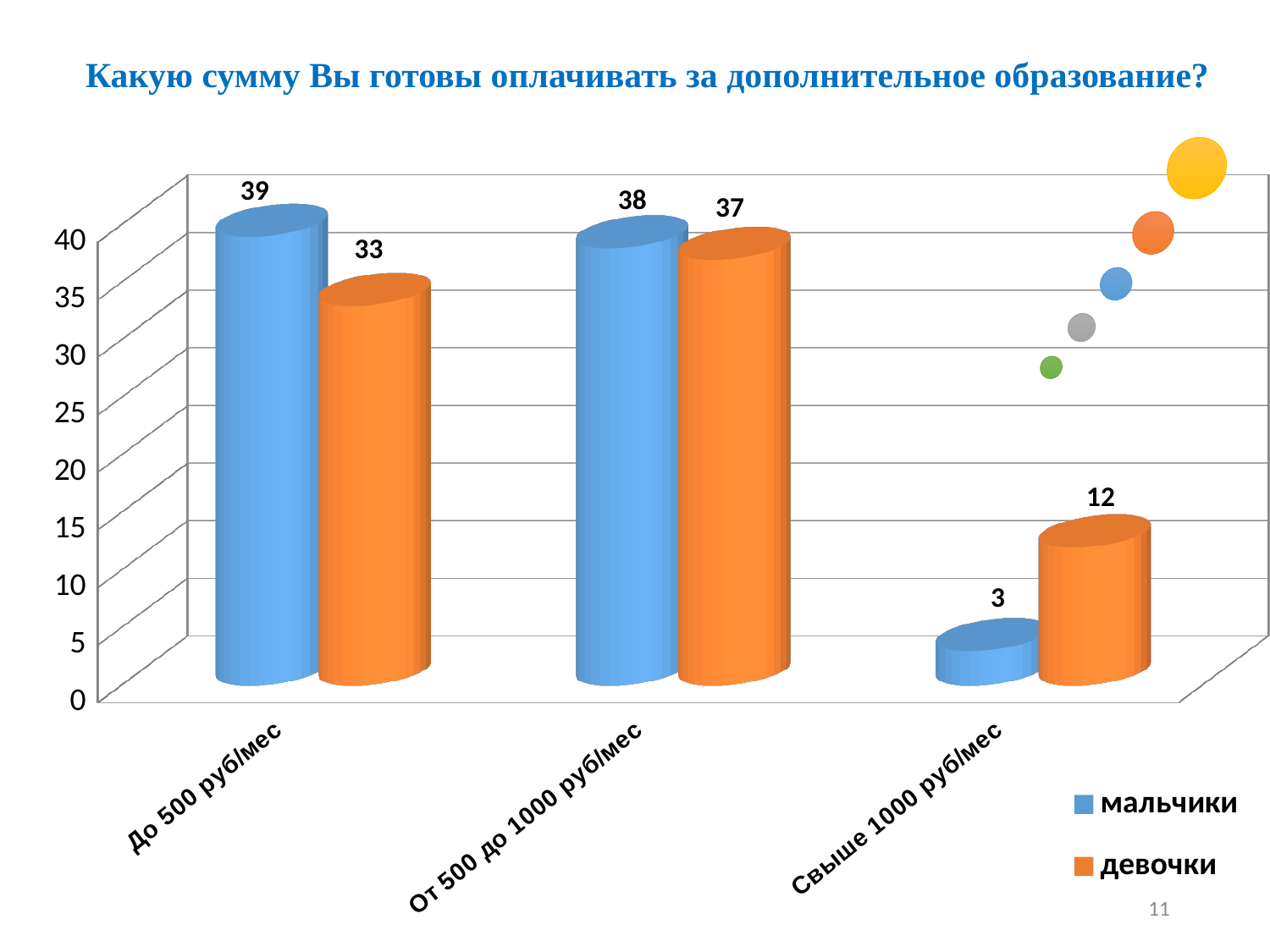
Which is larger in the category Свыше 1000 руб/мес: мальчики or девочки? девочки What is the value for девочки in the category От 500 до 1000 руб/мес? 37 What is the value for мальчики in the category До 500 руб/мес? 39 What is the difference between мальчики and девочки in the category До 500 руб/мес? 6 Which category has the lowest value for мальчики? Свыше 1000 руб/мес Which category has the highest value for девочки? От 500 до 1000 руб/мес How many categories are shown on the x axis? 3 Do the values for мальчики rise or fall from left to right along the x axis? fall What kind of chart is shown on the slide? bar chart What colour represents девочки in the chart? orange What is the value for девочки in the category Свыше 1000 руб/мес? 12 How many series does the legend list? 2